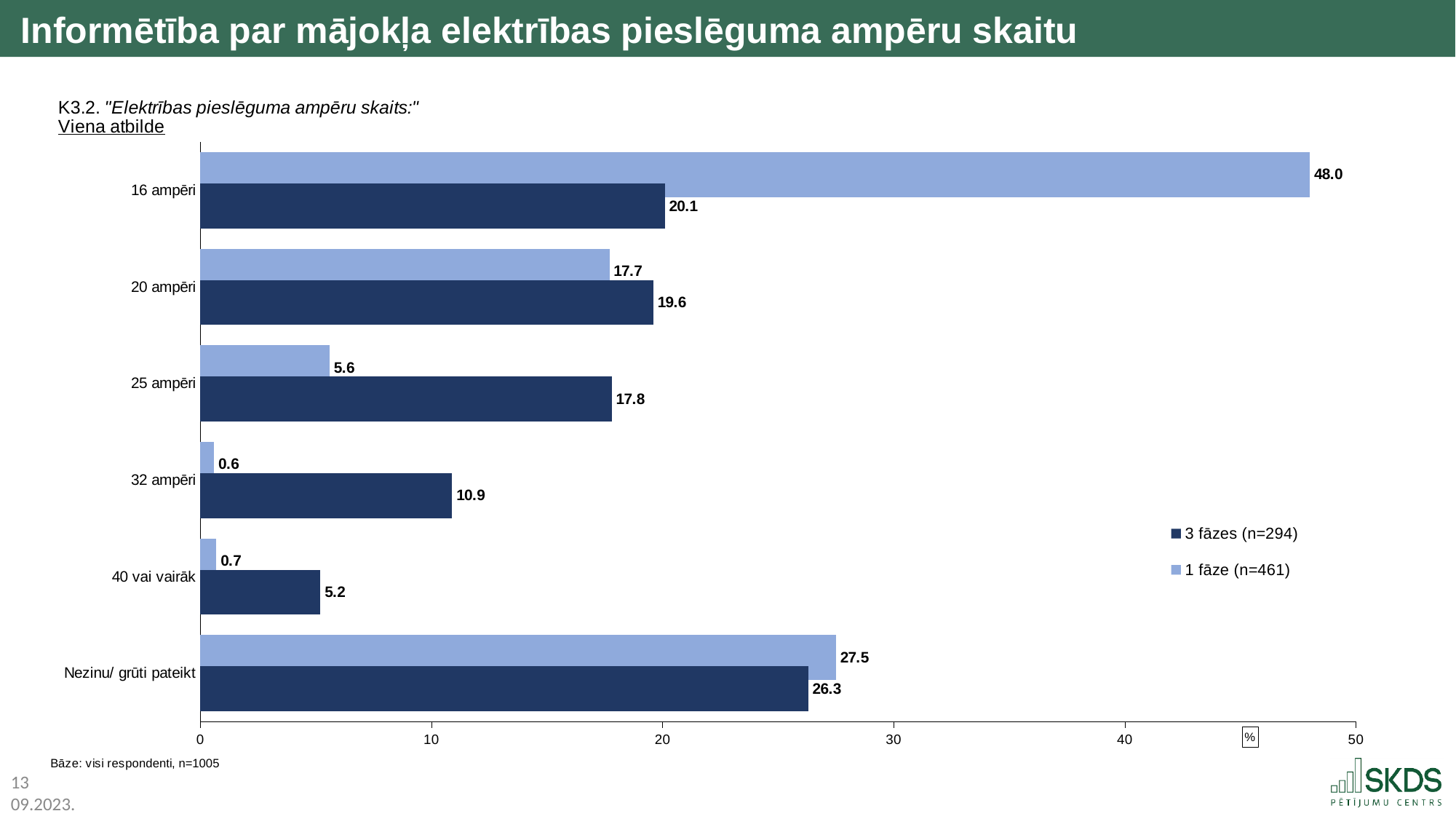
What is the value for '16 ampēri' in the '1 fāze (n=461)' series? 48.0 How many series does the legend list? 2 What is the value for '40 vai vairāk' in the '1 fāze (n=461)' series? 0.7 What is the sample size shown in the legend for the '1 fāze' series? n=461 Is the value for 'Nezinu/ grūti pateikt' in the '3 fāzes (n=294)' series greater or less than 20? greater What is the difference between the '1 fāze (n=461)' and '3 fāzes (n=294)' values for '16 ampēri'? 27.9 Which category has the lowest value in the '3 fāzes (n=294)' series? 40 vai vairāk How many categories are shown on the chart? 6 What is the value for '25 ampēri' in the '3 fāzes (n=294)' series? 17.8 For '32 ampēri', which series has the larger value: '3 fāzes (n=294)' or '1 fāze (n=461)'? 3 fāzes (n=294) Which category has the highest value in the '1 fāze (n=461)' series? 16 ampēri What kind of chart is shown on the slide? bar chart